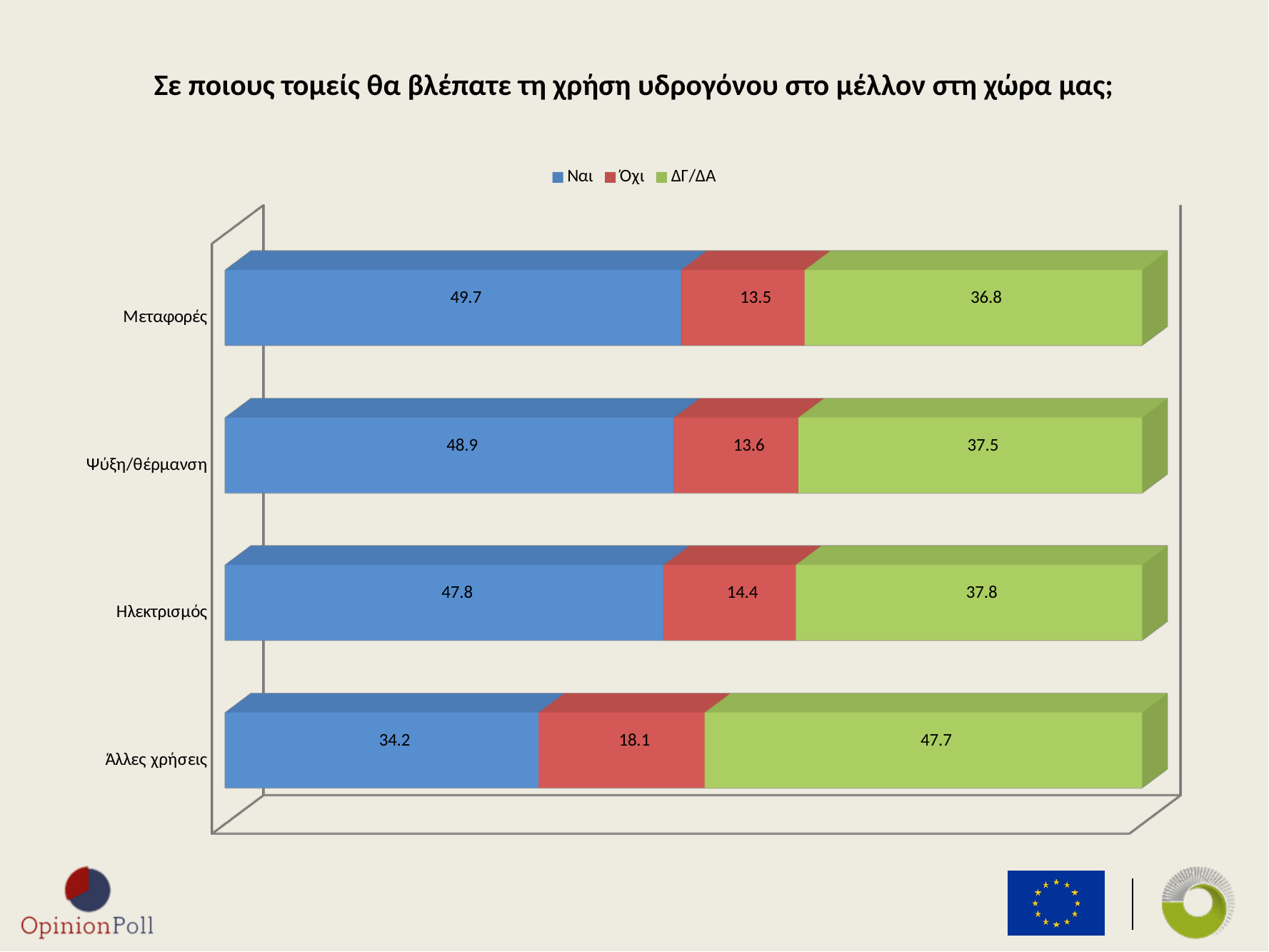
How many categories are shown in the chart? 4 What is the value of ΔΓ/ΔΑ for Άλλες χρήσεις? 47.7 What kind of chart is shown on the slide? Stacked bar chart What is the value of Ναι for Μεταφορές? 49.7 What is the difference between the Ναι values for Μεταφορές and Άλλες χρήσεις? 15.5 What is the value of Όχι for Ηλεκτρισμός? 14.4 Which category has the lowest Ναι value? Άλλες χρήσεις How many series does the legend list? 3 Which category has the highest Ναι value? Μεταφορές Which is larger: the ΔΓ/ΔΑ value for Ψύξη/θέρμανση or for Ηλεκτρισμός? Ηλεκτρισμός What is the total of the stacked bar for Ψύξη/θέρμανση? 100.0 Which category has the highest Όχι value? Άλλες χρήσεις